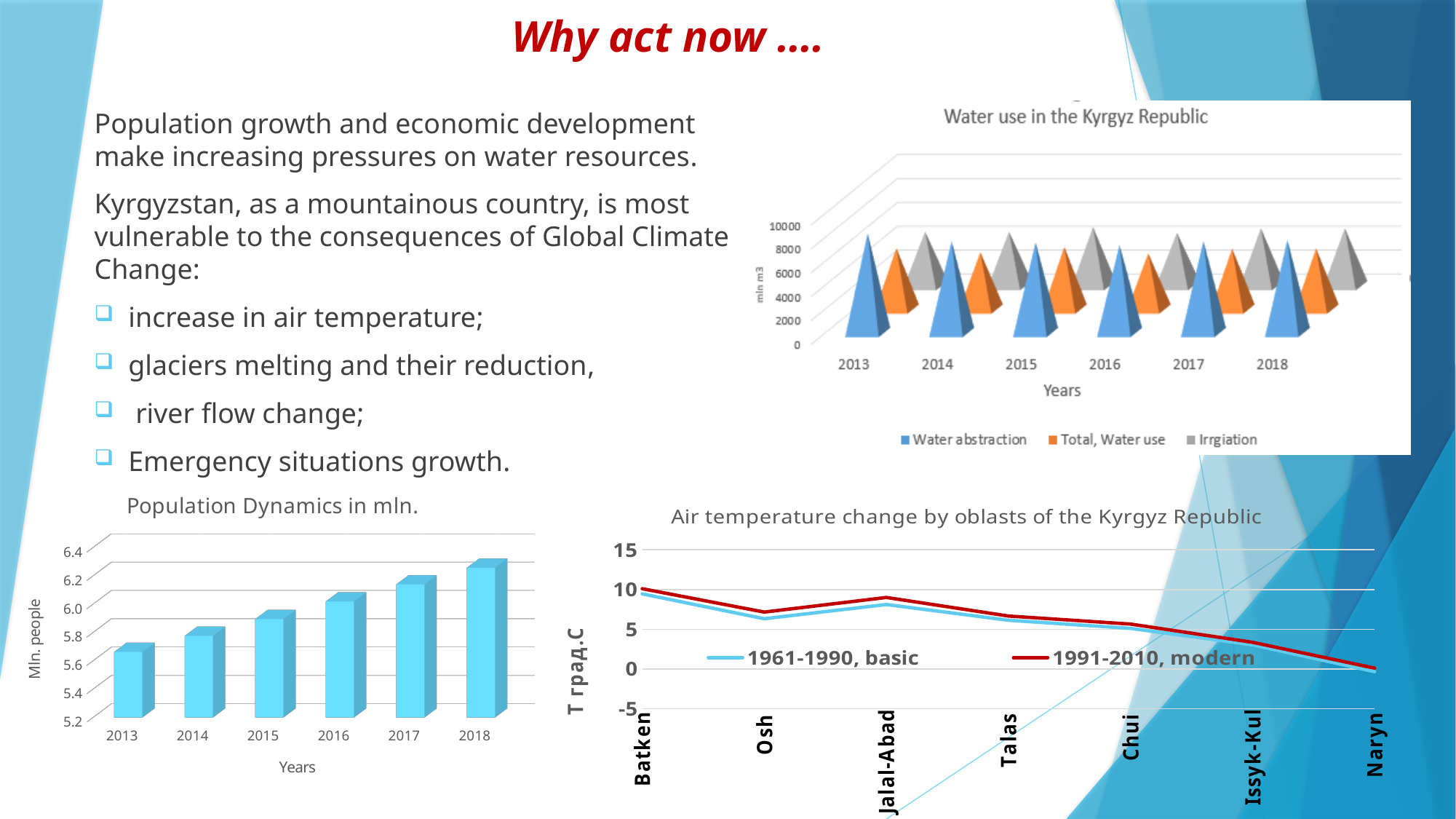
In the 'Population Dynamics in mln.' chart, is the value for 2017 greater or less than 6.0? greater How many oblasts are shown on the x axis of the 'Air temperature change by oblasts of the Kyrgyz Republic' chart? 7 In the 'Air temperature change by oblasts of the Kyrgyz Republic' chart, which oblast has the highest value for the 1991-2010, modern series? Batken How many years are shown on the x axis of the 'Water use in the Kyrgyz Republic' chart? 6 How many series does the legend of the 'Water use in the Kyrgyz Republic' chart list? 3 In the 'Population Dynamics in mln.' chart, which year has the highest population? 2018 In the 'Water use in the Kyrgyz Republic' chart, which is larger in 2013: Water abstraction or Total, Water use? Water abstraction In the 'Population Dynamics in mln.' chart, is the value for 2014 greater or less than 6.0? less In the 'Population Dynamics in mln.' chart, do the values rise or fall from 2013 to 2018? rise In the 'Population Dynamics in mln.' chart, which year has the lowest population? 2013 In the 'Air temperature change by oblasts of the Kyrgyz Republic' chart, is the 1991-2010, modern value for Naryn greater or less than 5? less What type of chart is 'Population Dynamics in mln.'? bar chart